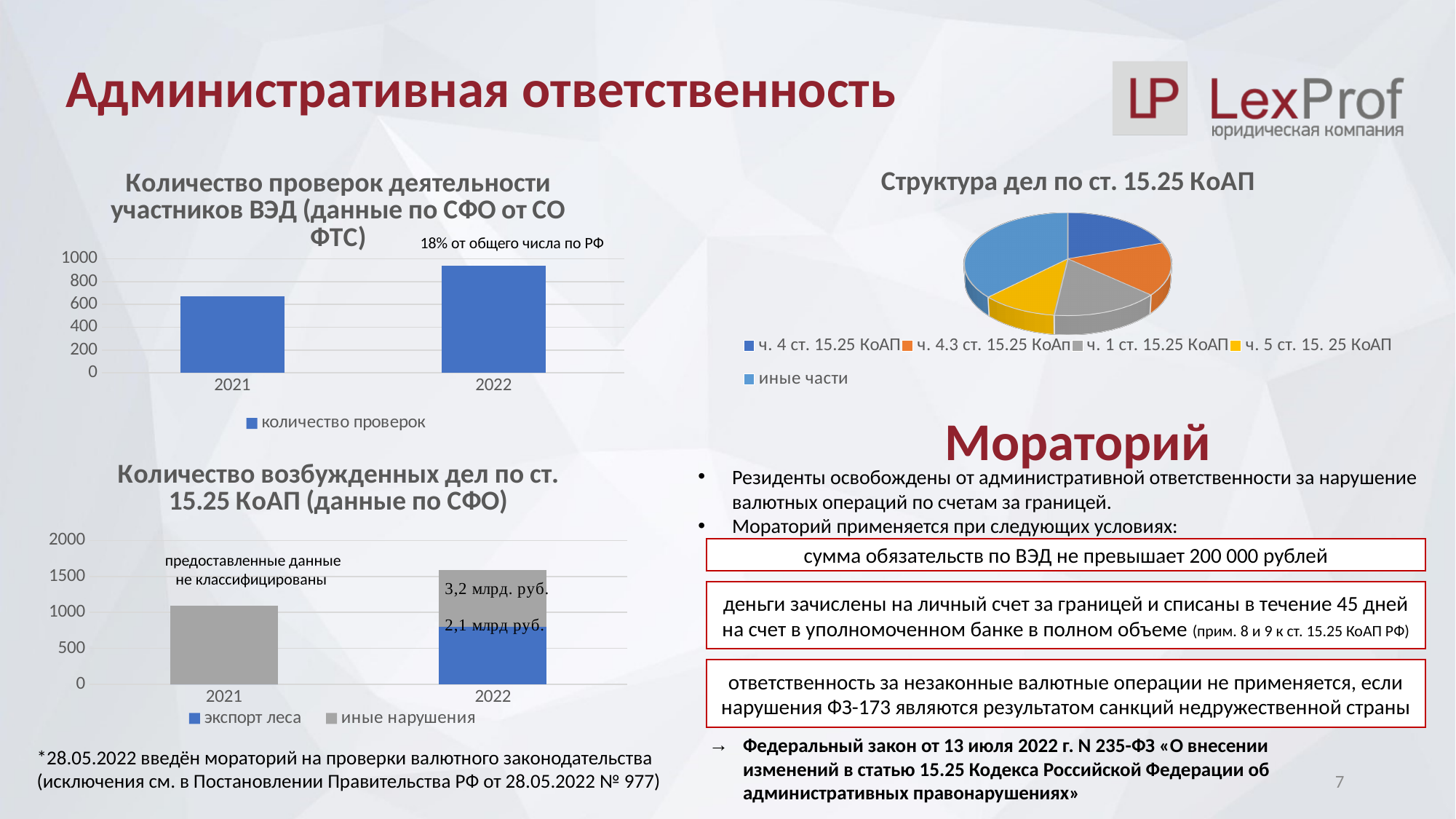
What type of chart is the chart titled "Количество проверок деятельности участников ВЭД (данные по СФО от СО ФТС)"? bar chart In the chart "Количество проверок деятельности участников ВЭД", is the value for 2021 greater or less than 800? less What type of chart is the chart titled "Структура дел по ст. 15.25 КоАП"? pie chart How many series does the legend of the chart "Количество возбужденных дел по ст. 15.25 КоАП (данные по СФО)" list? 2 In the chart "Количество возбужденных дел по ст. 15.25 КоАП (данные по СФО)", what amount is labelled on the "экспорт леса" segment for 2022? 2,1 млрд руб. In the chart "Количество проверок деятельности участников ВЭД", which year has the higher number of inspections, 2021 or 2022? 2022 In the chart "Количество проверок деятельности участников ВЭД", what share of the total for the Russian Federation does the 2022 bar represent, according to the annotation? 18% от общего числа по РФ In the chart "Количество возбужденных дел по ст. 15.25 КоАП (данные по СФО)", is the value for 2021 greater or less than 1500? less How many categories does the legend of the pie chart "Структура дел по ст. 15.25 КоАП" list? 5 In the chart "Количество проверок деятельности участников ВЭД", is the value for 2022 greater or less than 800? greater In the chart "Количество проверок деятельности участников ВЭД", do the values rise or fall from 2021 to 2022? rise